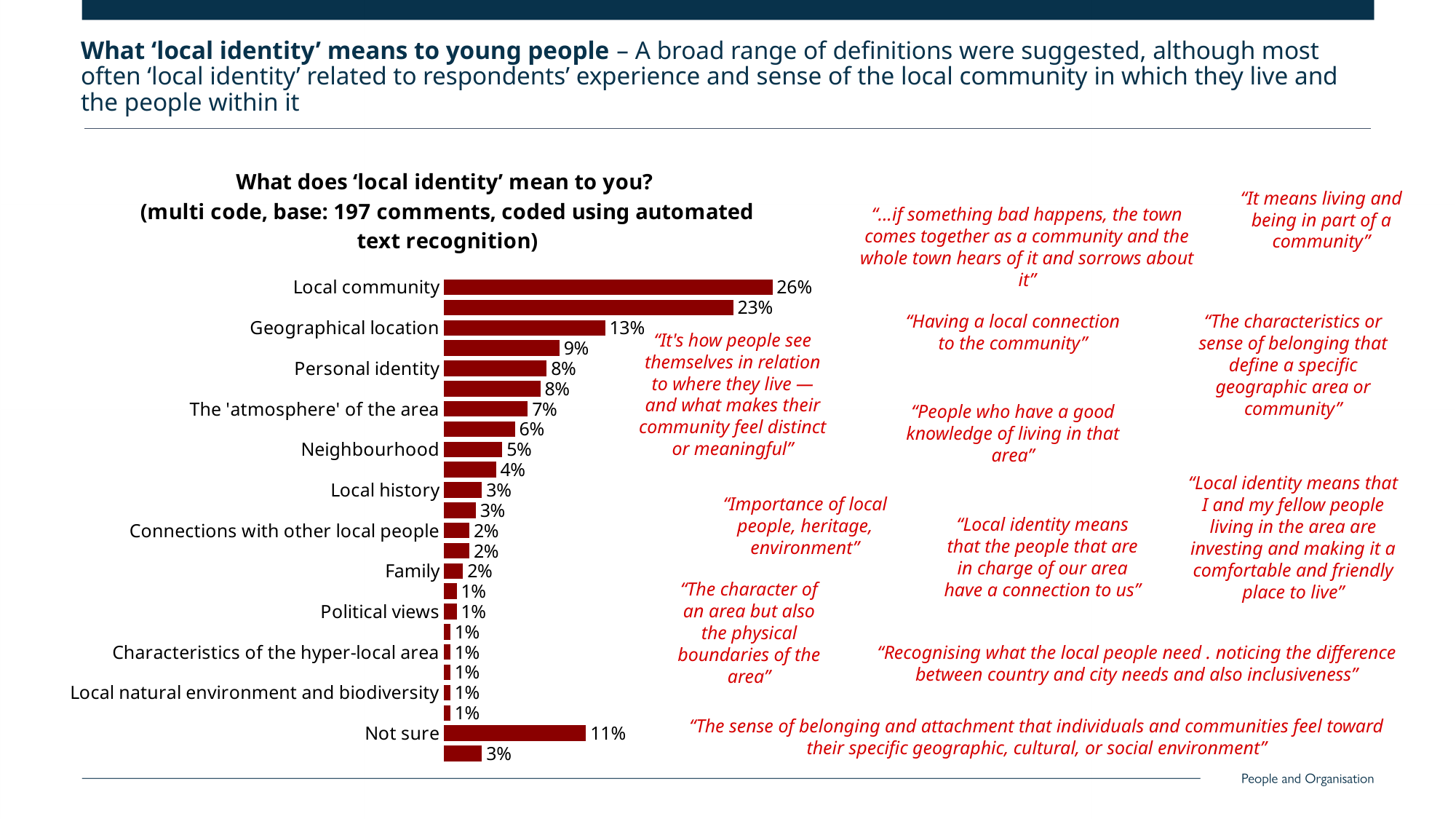
What kind of chart is shown on the slide? Bar chart What percentage is shown for Neighbourhood? 5% What percentage is shown for Geographical location? 13% What is the title of the chart? What does ‘local identity’ mean to you? (multi code, base: 197 comments, coded using automated text recognition) What percentage is shown for Local community? 26% Which labelled category has the highest percentage? Local community Which has the larger percentage, Not sure or Personal identity? Not sure What percentage is shown for The 'atmosphere' of the area? 7% What percentage is shown for Personal identity? 8% What percentage is shown for Not sure? 11% What is the difference in percentage points between Not sure and Neighbourhood? 6 percentage points What is the difference in percentage points between Local community and Geographical location? 13 percentage points